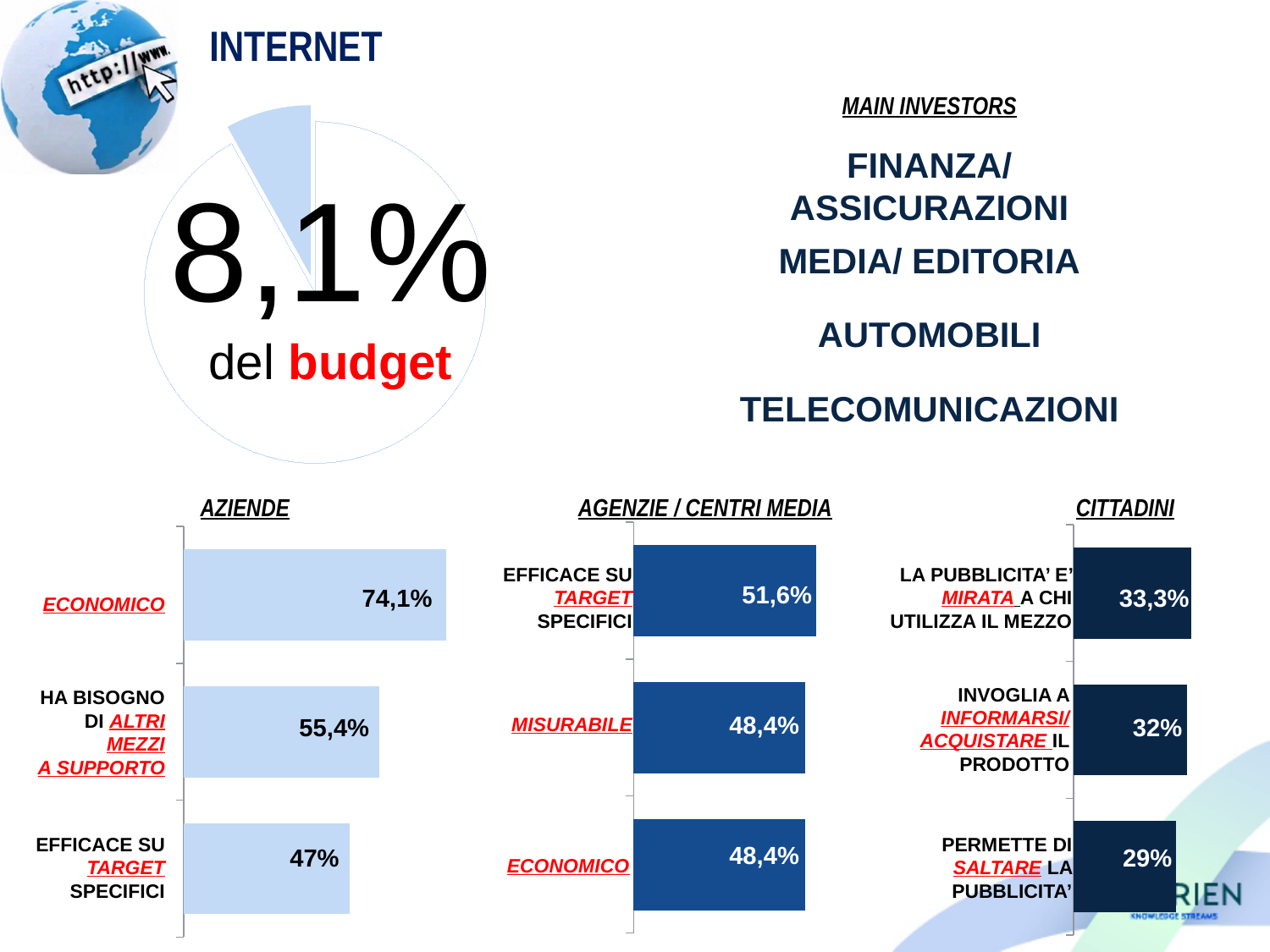
In the AZIENDE chart, what is the difference between ECONOMICO and HA BISOGNO DI ALTRI MEZZI A SUPPORTO? 18,7% In the AGENZIE / CENTRI MEDIA chart, which is larger: EFFICACE SU TARGET SPECIFICI or MISURABILE? EFFICACE SU TARGET SPECIFICI In the AZIENDE chart, what is the value for ECONOMICO? 74,1% What kind of chart is the CITTADINI chart? Bar chart How many categories does the AGENZIE / CENTRI MEDIA chart show? 3 In the CITTADINI chart, what is the value for INVOGLIA A INFORMARSI/ACQUISTARE IL PRODOTTO? 32% In the CITTADINI chart, which category has the lowest value? PERMETTE DI SALTARE LA PUBBLICITA' In the AZIENDE chart, what is the value for EFFICACE SU TARGET SPECIFICI? 47% In the AGENZIE / CENTRI MEDIA chart, what is the value for EFFICACE SU TARGET SPECIFICI? 51,6% In the AZIENDE chart, which category has the highest value? ECONOMICO What share of the budget does the pie chart at the top left show for Internet? 8,1% In the CITTADINI chart, what is the difference between LA PUBBLICITA' E' MIRATA A CHI UTILIZZA IL MEZZO and PERMETTE DI SALTARE LA PUBBLICITA'? 4,3%